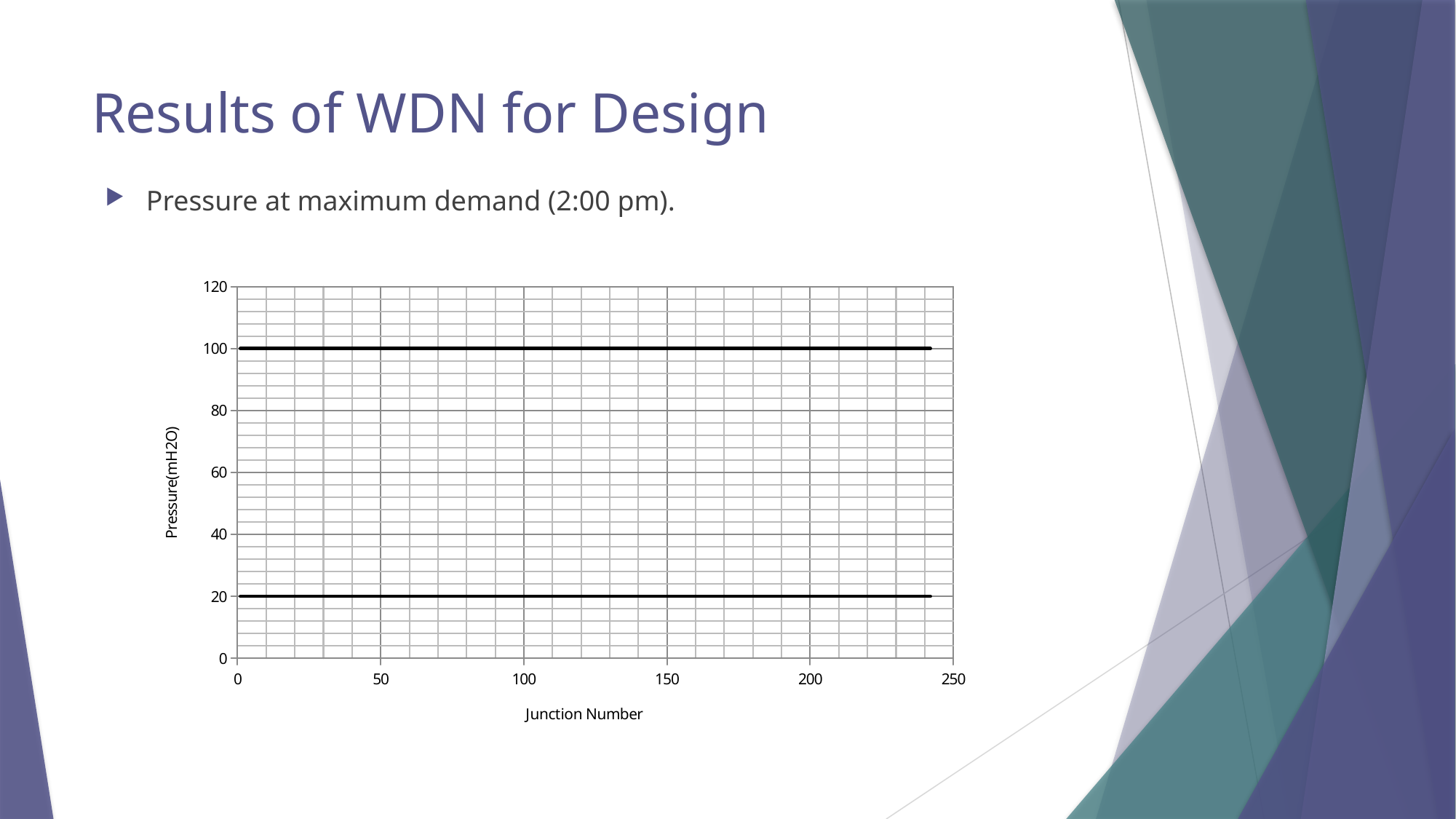
What kind of chart is shown on the slide? line chart How many lines are plotted on the chart? 2 What is the label of the vertical axis of the chart? Pressure(mH2O) Is the value of the upper line greater or less than 80? greater What is the difference in pressure between the upper line and the lower line? 80 Is the value of the lower line greater or less than 40? less What is the highest value shown on the vertical axis? 120 At what pressure value does the lower horizontal line sit? 20 Do the plotted pressure values rise, fall, or stay flat as the junction number increases? stay flat At what pressure value does the upper horizontal line sit? 100 Which line has the larger pressure value, the upper line or the lower line? the upper line What is the label of the horizontal axis of the chart? Junction Number